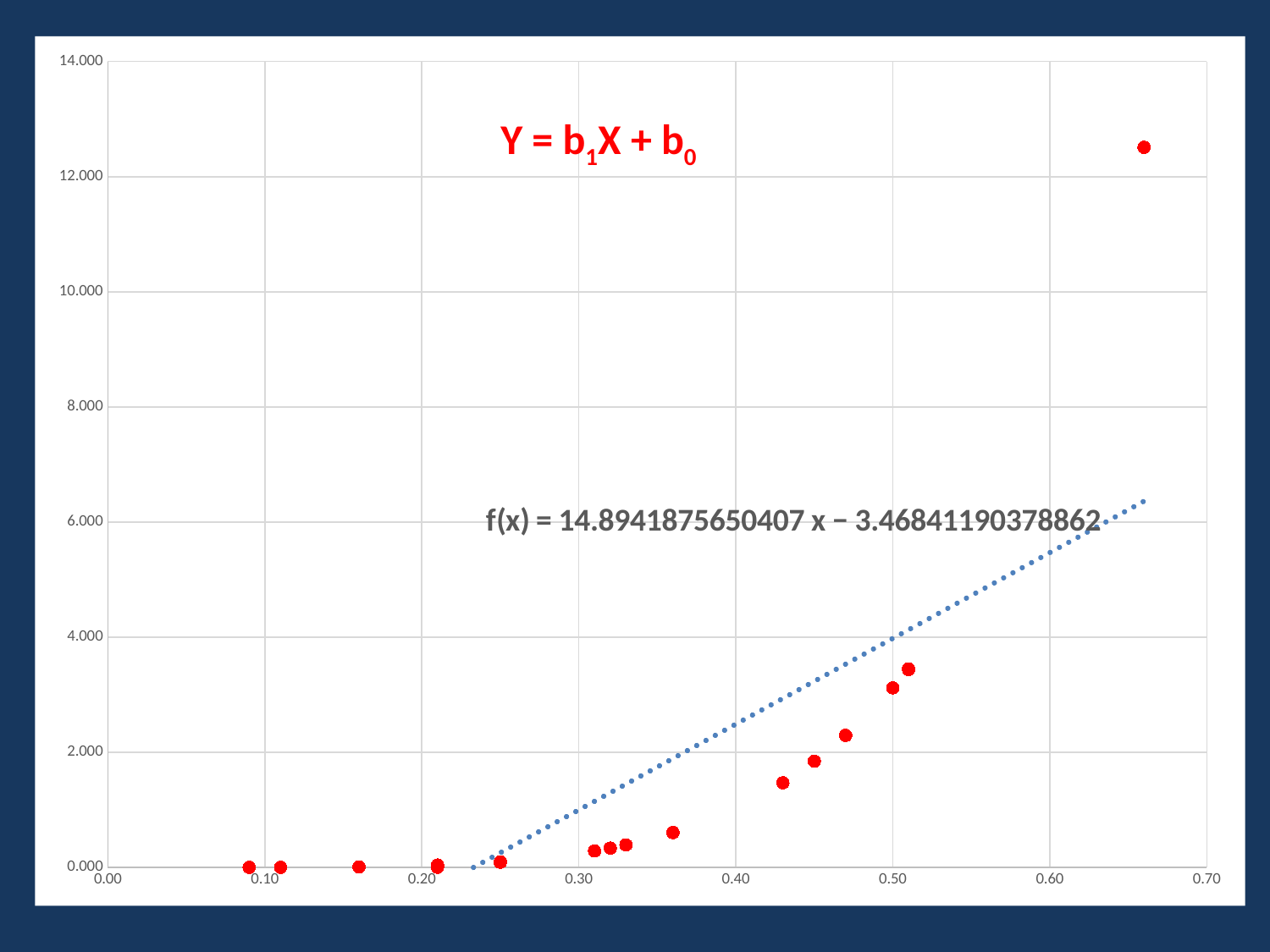
Is the y value of the plotted point near x = 0.50 greater or less than 2.000? greater Is the y value of the plotted point near x = 0.43 greater or less than 2.000? less What is the highest tick value shown on the y axis? 14.000 Is the y value of the highest plotted point (near x = 0.66) greater or less than 12.000? greater Do the plotted values generally rise or fall as x increases along the x axis? rise What kind of chart is shown on the slide? scatter chart What is the intercept in the fitted line equation shown on the chart? −3.46841190378862 What is the highest tick value shown on the x axis? 0.70 What is the slope coefficient in the fitted line equation shown on the chart? 14.8941875650407